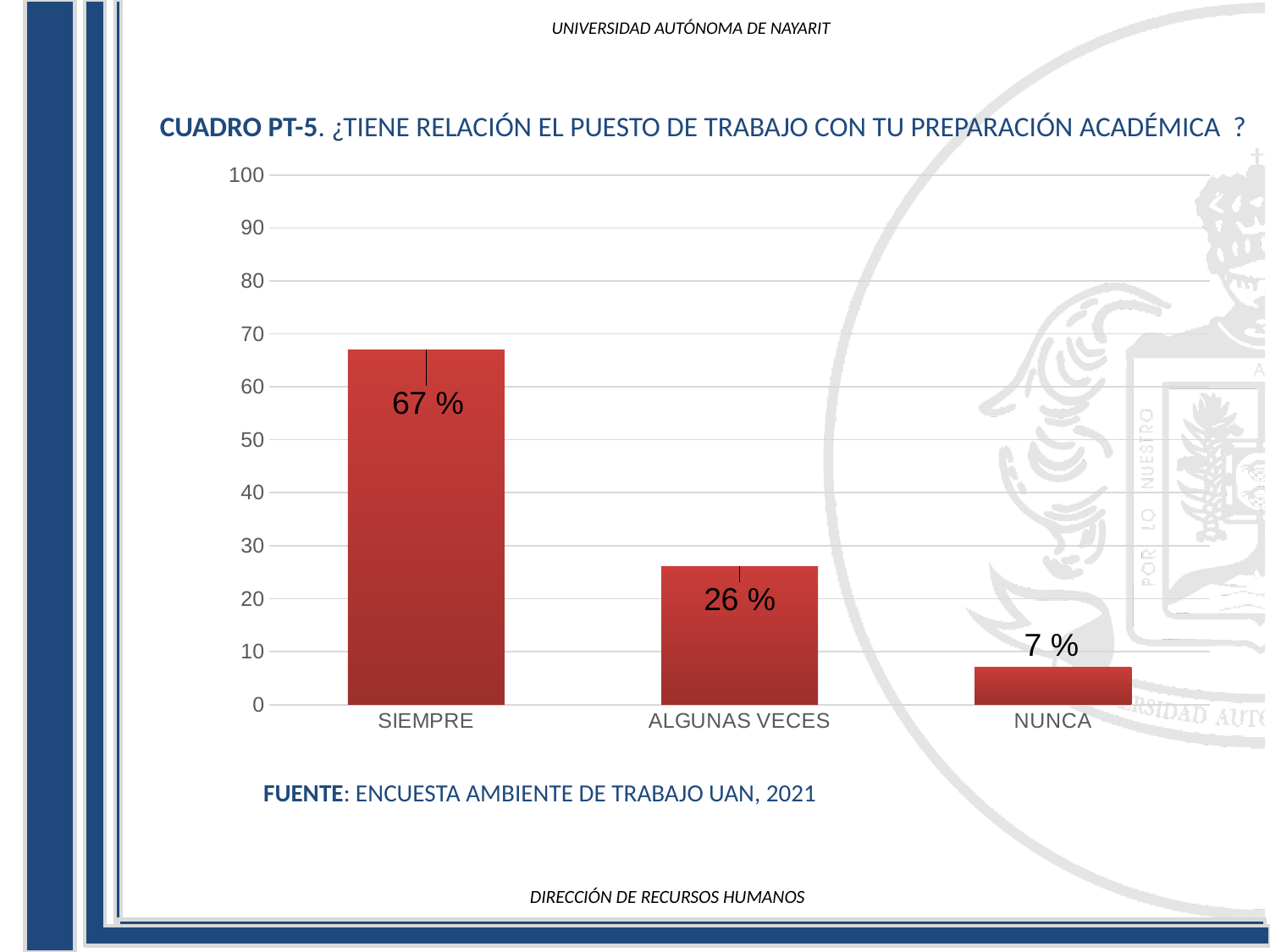
What kind of chart is shown on the slide? bar chart Do the values rise or fall from left to right along the x axis? fall Is the value for SIEMPRE greater or less than 60? greater Which category has the highest value? SIEMPRE What is the difference between the values for ALGUNAS VECES and NUNCA? 19 % What is the value for ALGUNAS VECES? 26 % What is the value for NUNCA? 7 % What is the difference between the values for SIEMPRE and ALGUNAS VECES? 41 % Which category has the lowest value? NUNCA How many categories are shown on the x axis? 3 Which is larger, the value for ALGUNAS VECES or the value for NUNCA? ALGUNAS VECES What is the value for SIEMPRE? 67 %